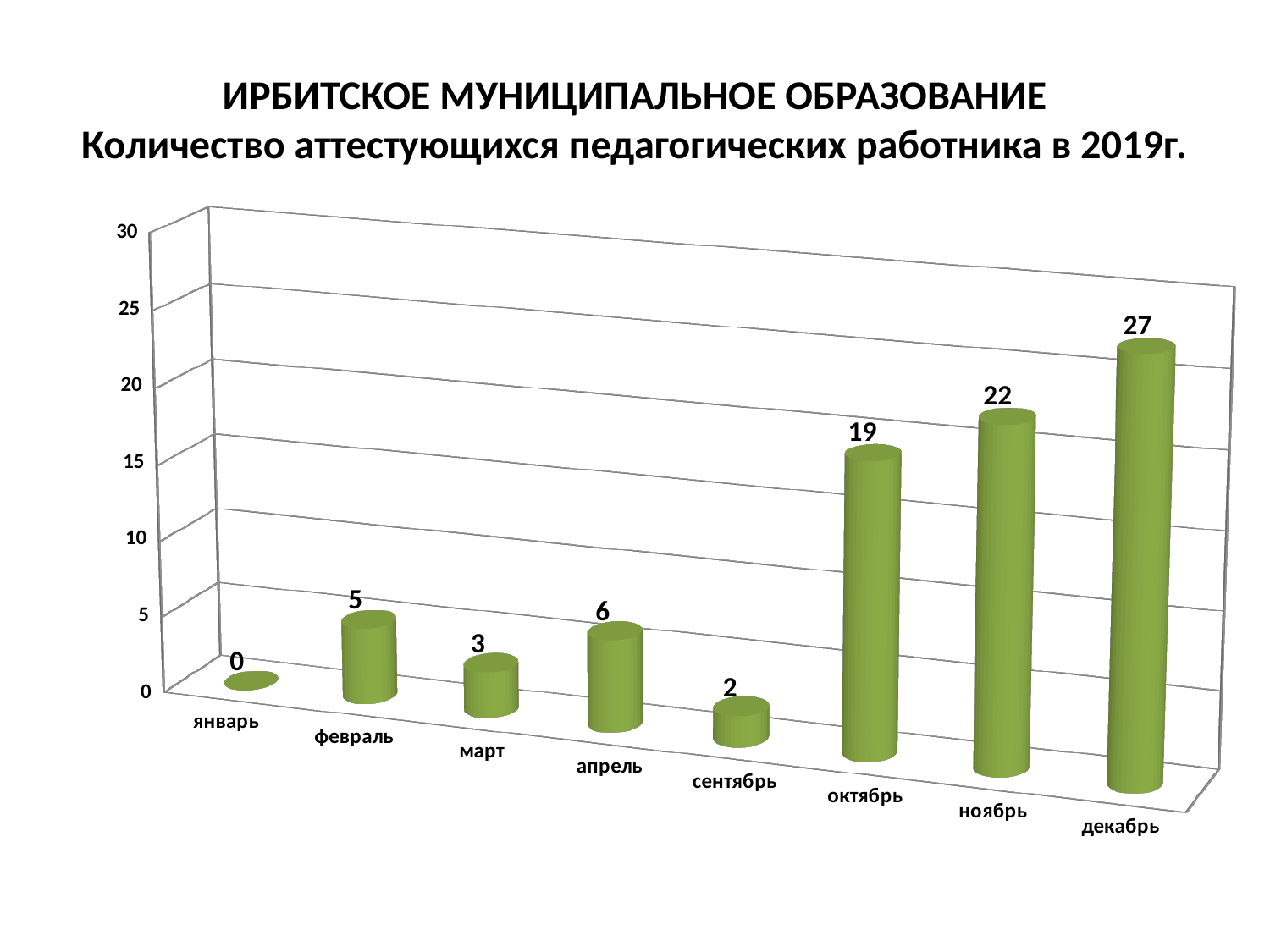
What is the difference between the values for декабрь and ноябрь? 5 Is the value for ноябрь greater or less than 20? greater What is the difference between the values for апрель and март? 3 Which month has the highest value? декабрь What is the value for октябрь? 19 What is the value for сентябрь? 2 Which is larger, the value for апрель or the value for февраль? апрель What is the value for февраль? 5 What is the highest tick value shown on the vertical axis? 30 What kind of chart is shown on the slide? bar chart How many months are shown on the x axis? 8 Which month has the lowest value? январь